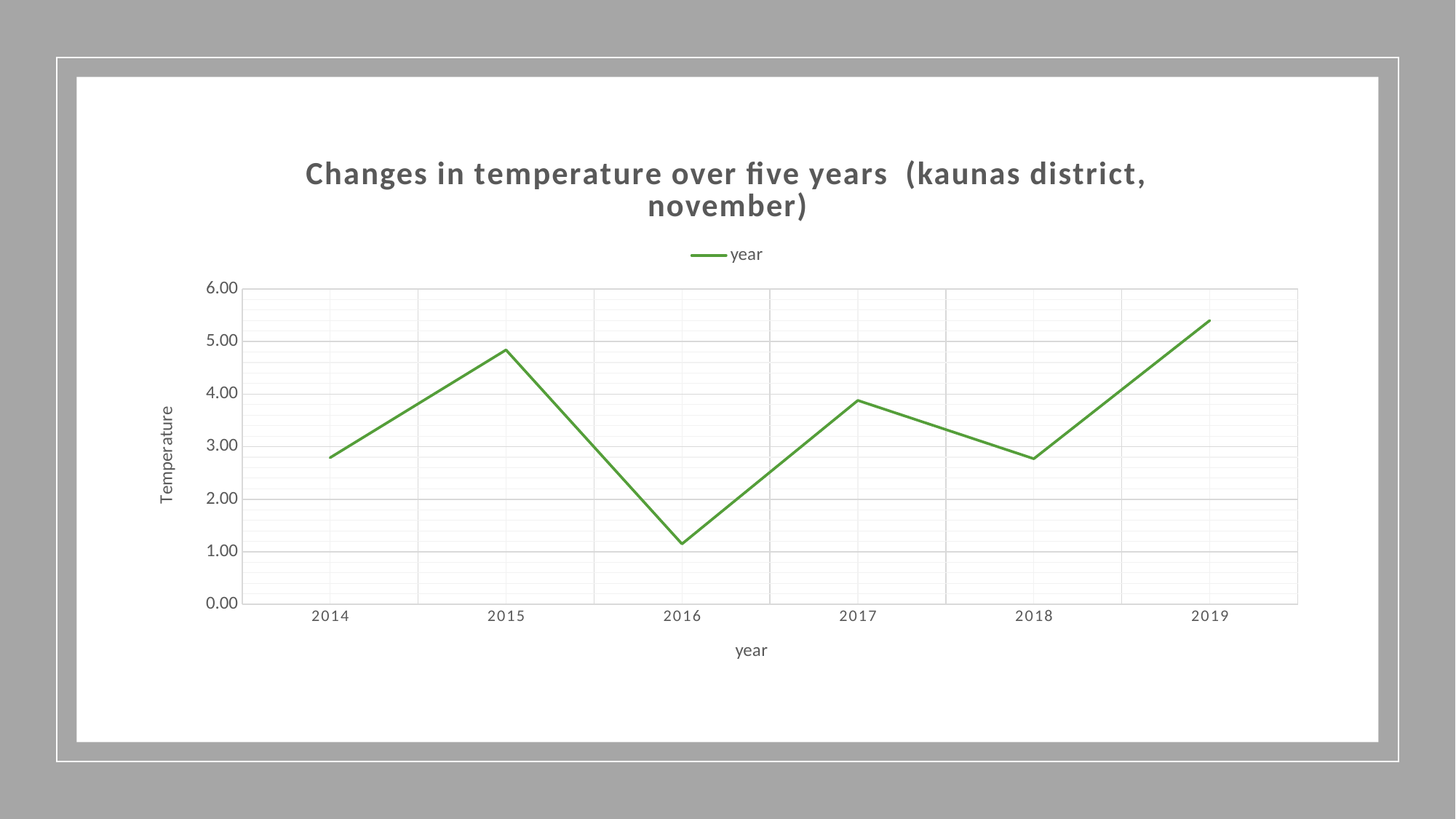
Which year has the highest temperature? 2019 Is the temperature for 2015 greater or less than 4.00? greater What kind of chart is shown on the slide? line chart Is the temperature for 2019 greater or less than 5.00? greater How many years are plotted on the x axis? 6 Which year has the higher temperature, 2015 or 2016? 2015 How many series does the legend list? 1 Is the temperature for 2016 greater or less than 2.00? less Does the temperature rise or fall from 2018 to 2019? rise What is the title of the chart? Changes in temperature over five years (kaunas district, november) Which year has the lowest temperature? 2016 What is the label on the vertical axis? Temperature